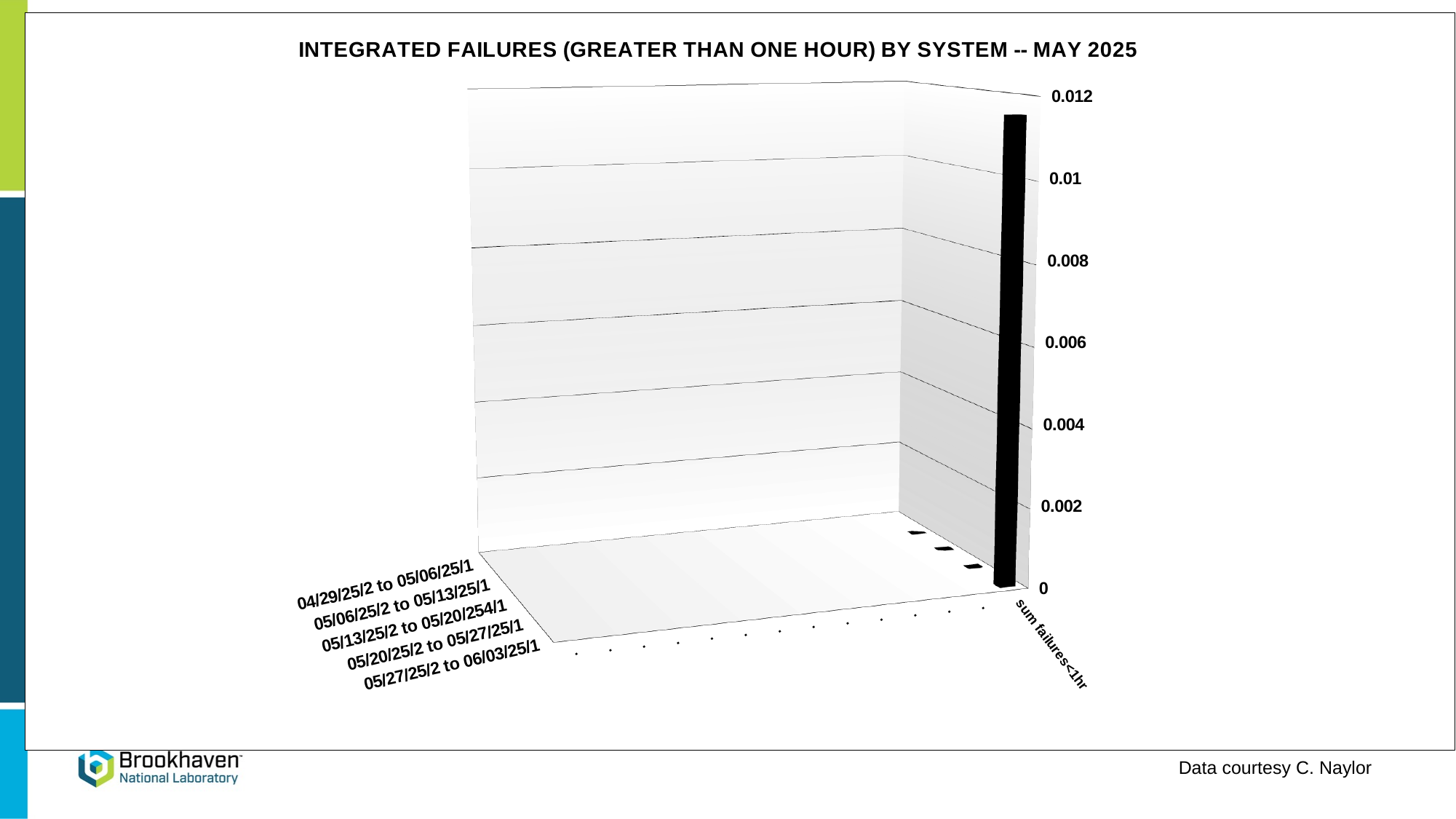
Is the value of the tallest bar in the chart greater or less than 0.01? greater What kind of chart is shown on the slide? bar chart How many date-range categories are labelled along the x axis of the chart? 5 Is the value of the tallest bar in the chart greater or less than 0.012? less What is the title of the chart? INTEGRATED FAILURES (GREATER THAN ONE HOUR) BY SYSTEM -- MAY 2025 What is the readable label at the far right end of the depth axis of the chart? sum failures<1hr